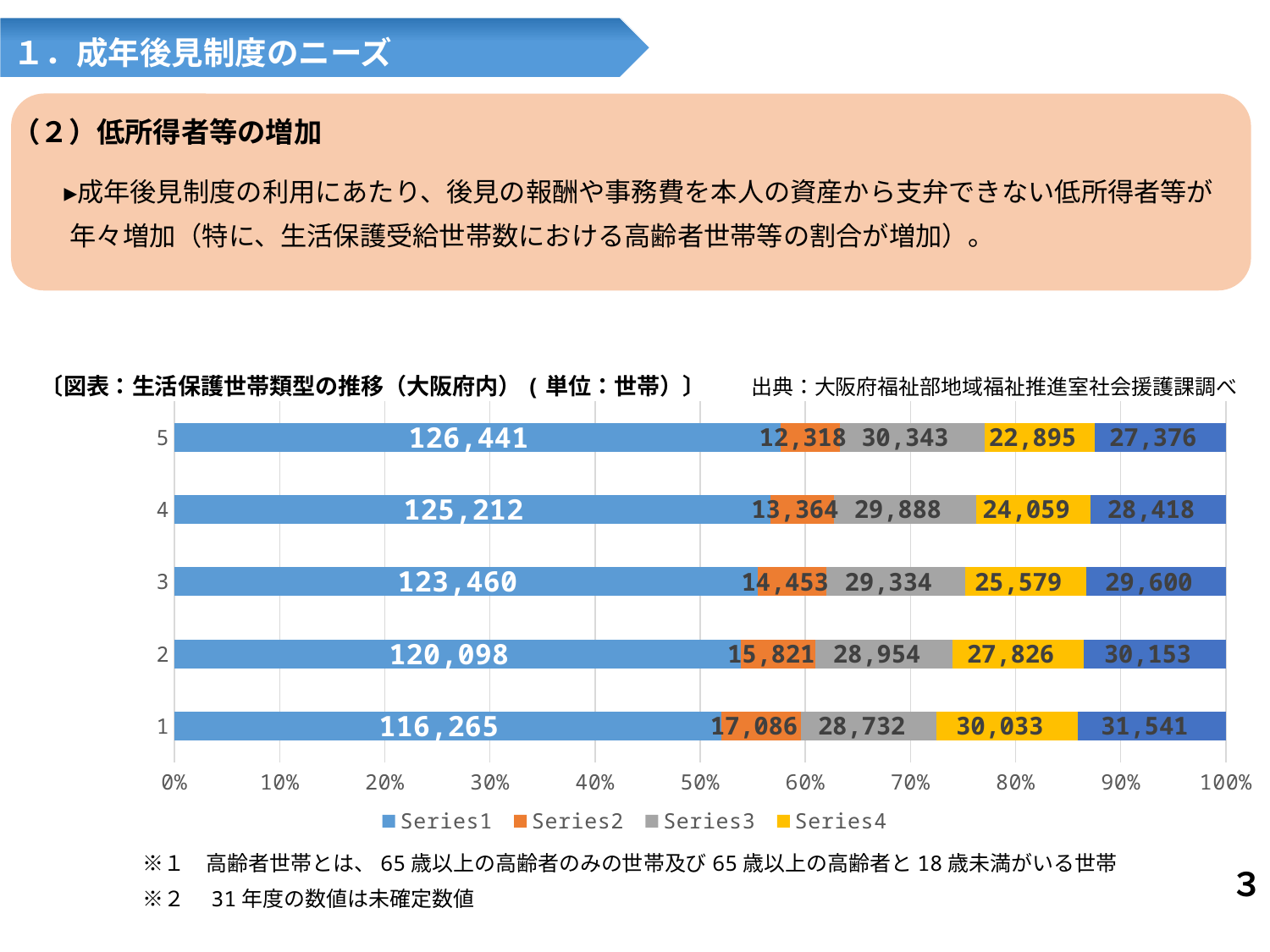
What is the Series2 value for category 1? 17,086 How many categories are shown on the vertical axis of the chart? 5 What is the Series4 value for category 3? 25,579 Which category has the lowest Series2 value? 5 Do the Series1 values rise or fall going from category 1 to category 5? Rise Which is larger, the Series3 value for category 5 or the Series3 value for category 1? Category 5 (30,343) What is the Series1 value for category 5? 126,441 What is the difference between the Series1 value for category 5 and the Series1 value for category 1? 10,176 What type of chart is shown on the slide? Stacked bar chart What is the Series3 value for category 2? 28,954 Which category has the highest Series1 value? 5 How many series does the legend list? 4